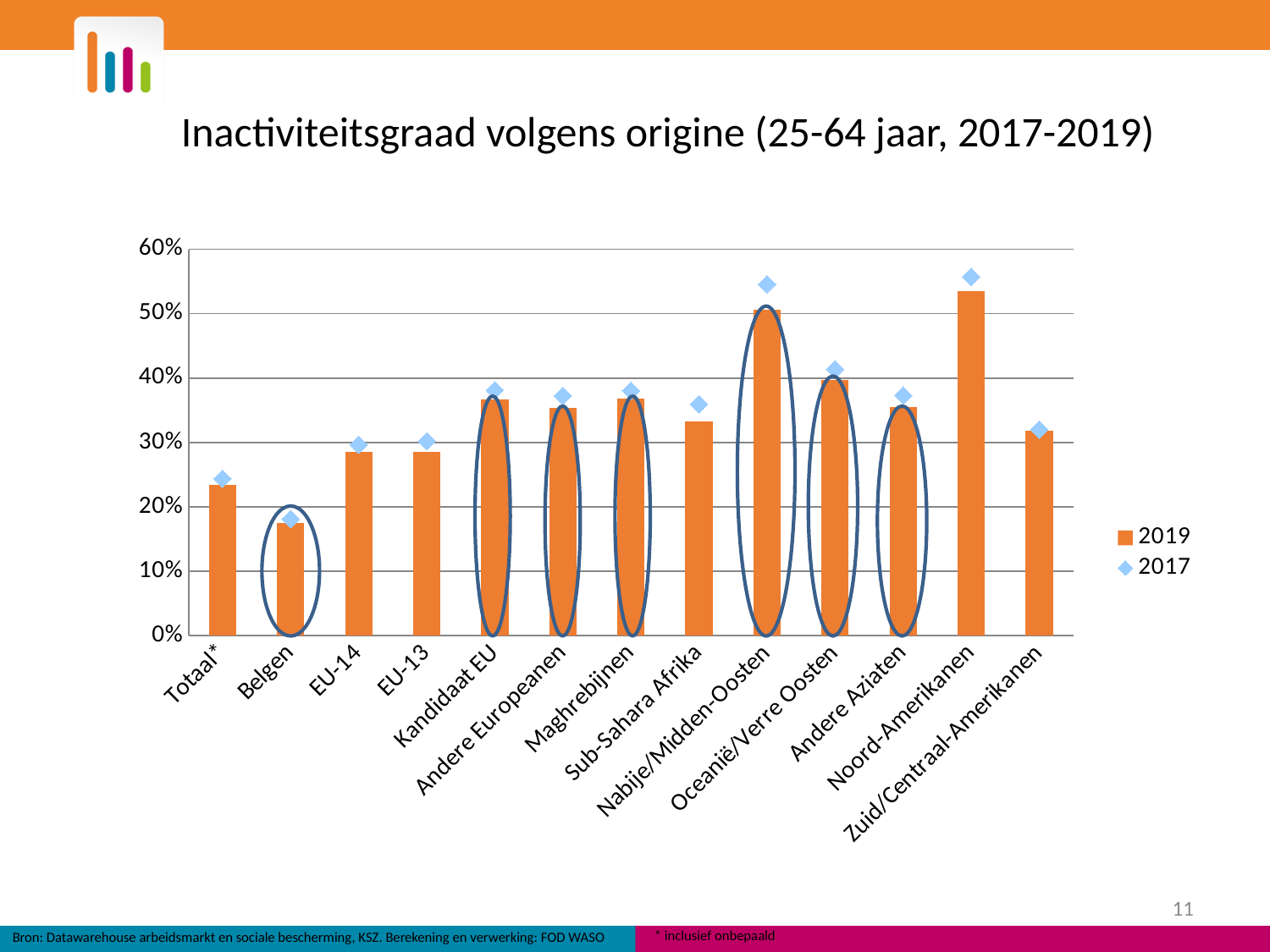
Which has the larger 2019 value, Oceanië/Verre Oosten or Sub-Sahara Afrika? Oceanië/Verre Oosten What kind of chart is shown on the slide? bar chart What is the title of the chart? Inactiviteitsgraad volgens origine (25-64 jaar, 2017-2019) Is the 2019 value for EU-14 greater or less than 30%? less How many series does the legend list? 2 Which category has the lowest 2019 value? Belgen Is the 2019 value for Noord-Amerikanen greater or less than 50%? greater Is the 2019 value for Belgen greater or less than 20%? less Which category has the highest 2019 value? Noord-Amerikanen How many origin categories are shown on the x axis? 13 Which has the larger 2019 value, Kandidaat EU or EU-13? Kandidaat EU